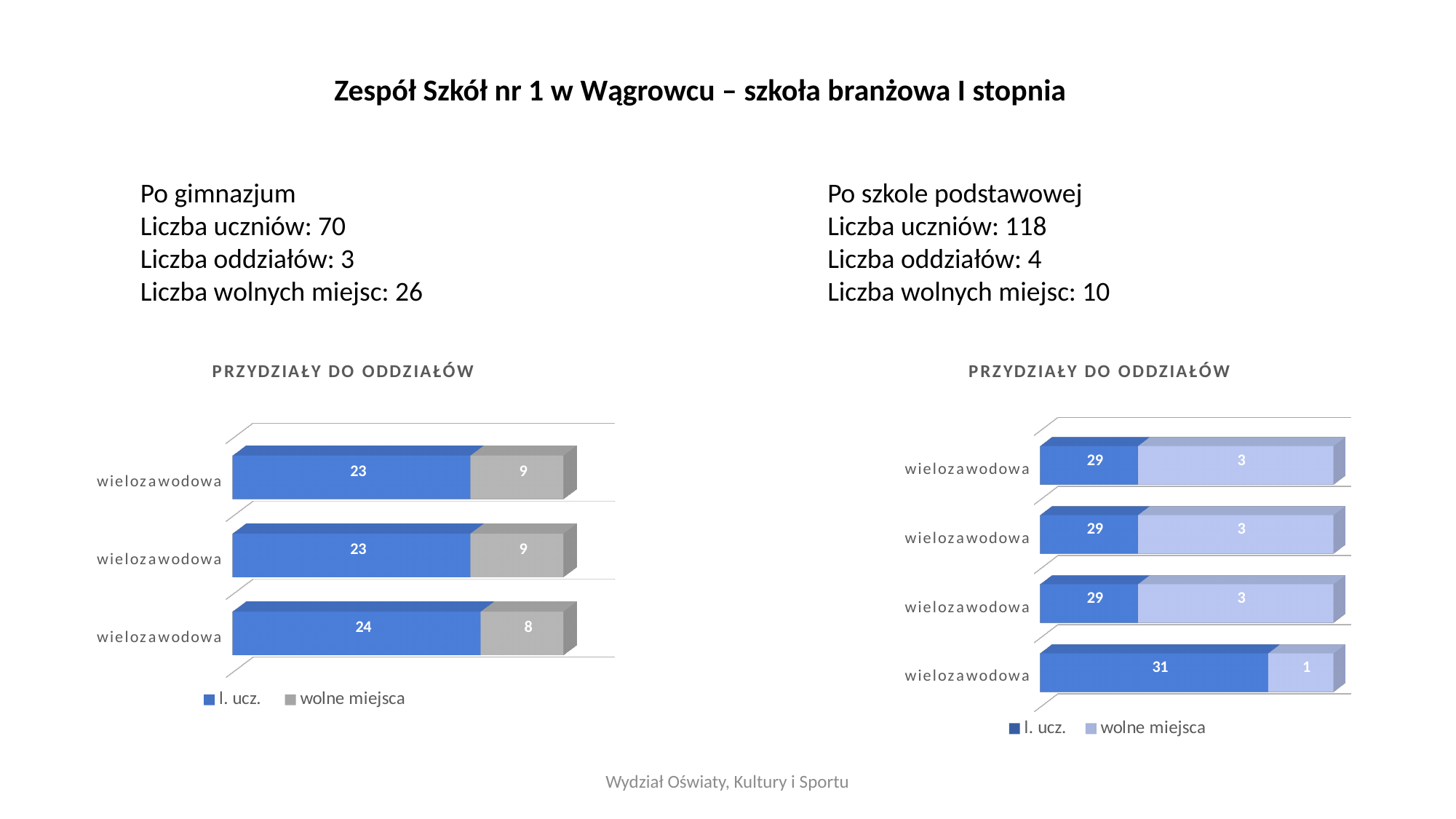
What kind of chart is the left chart titled 'PRZYDZIAŁY DO ODDZIAŁÓW'? bar chart What are the two legend entries of the right chart? l. ucz. and wolne miejsca In the right chart, what is the 'wolne miejsca' value for the bottom bar? 1 In the right chart, which bar has the highest 'l. ucz.' value? the bottom bar (31) In the left chart, what is the difference between 'l. ucz.' and 'wolne miejsca' for the bottom bar? 16 In the left chart, what is the 'l. ucz.' value for the bottom bar? 24 In the left chart, what is the total of the bottom stacked bar (l. ucz. plus wolne miejsca)? 32 In the right chart, how many bars (categories) are plotted? 4 In the right chart, what is the 'l. ucz.' value for the top bar? 29 In the left chart, how many series does the legend list? 2 In the right chart, what is the total of the bottom stacked bar (l. ucz. plus wolne miejsca)? 32 In the left chart, how many bars (categories) are plotted? 3